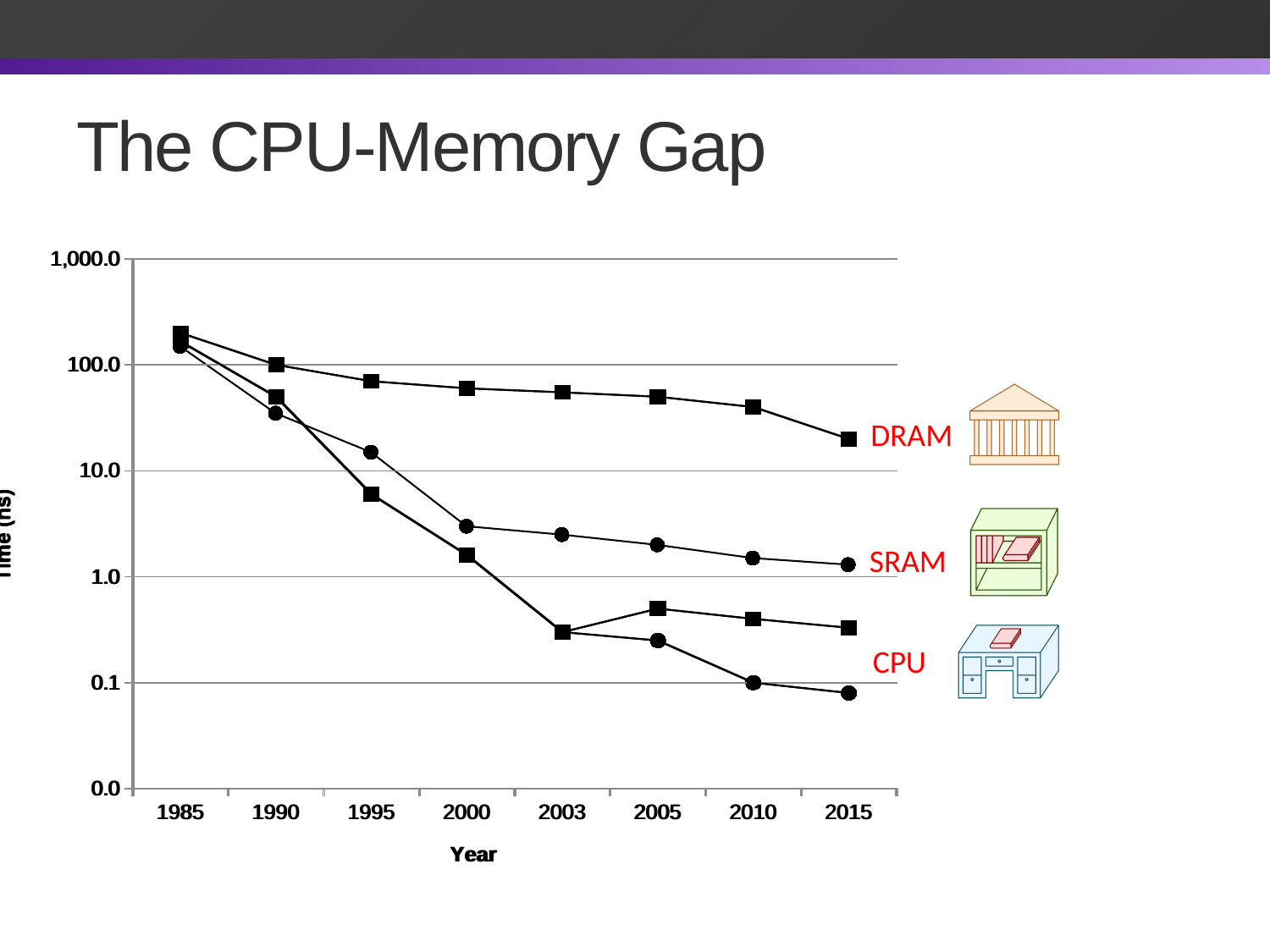
Is the SRAM value in 1995 greater or less than 10.0? greater Is the DRAM value in 1995 greater or less than 100.0? less Is the DRAM value in 2015 greater or less than 10.0? greater What kind of chart is shown on the slide? line chart How many years are marked along the x axis? 8 What is the title of the chart on the slide? The CPU-Memory Gap Which series has the lowest value in 2015? CPU What is the label of the x axis? Year Does the DRAM line rise or fall from 1985 to 2015? fall In 2015, which is larger, the DRAM value or the SRAM value? DRAM Which series has the highest value in 2015? DRAM